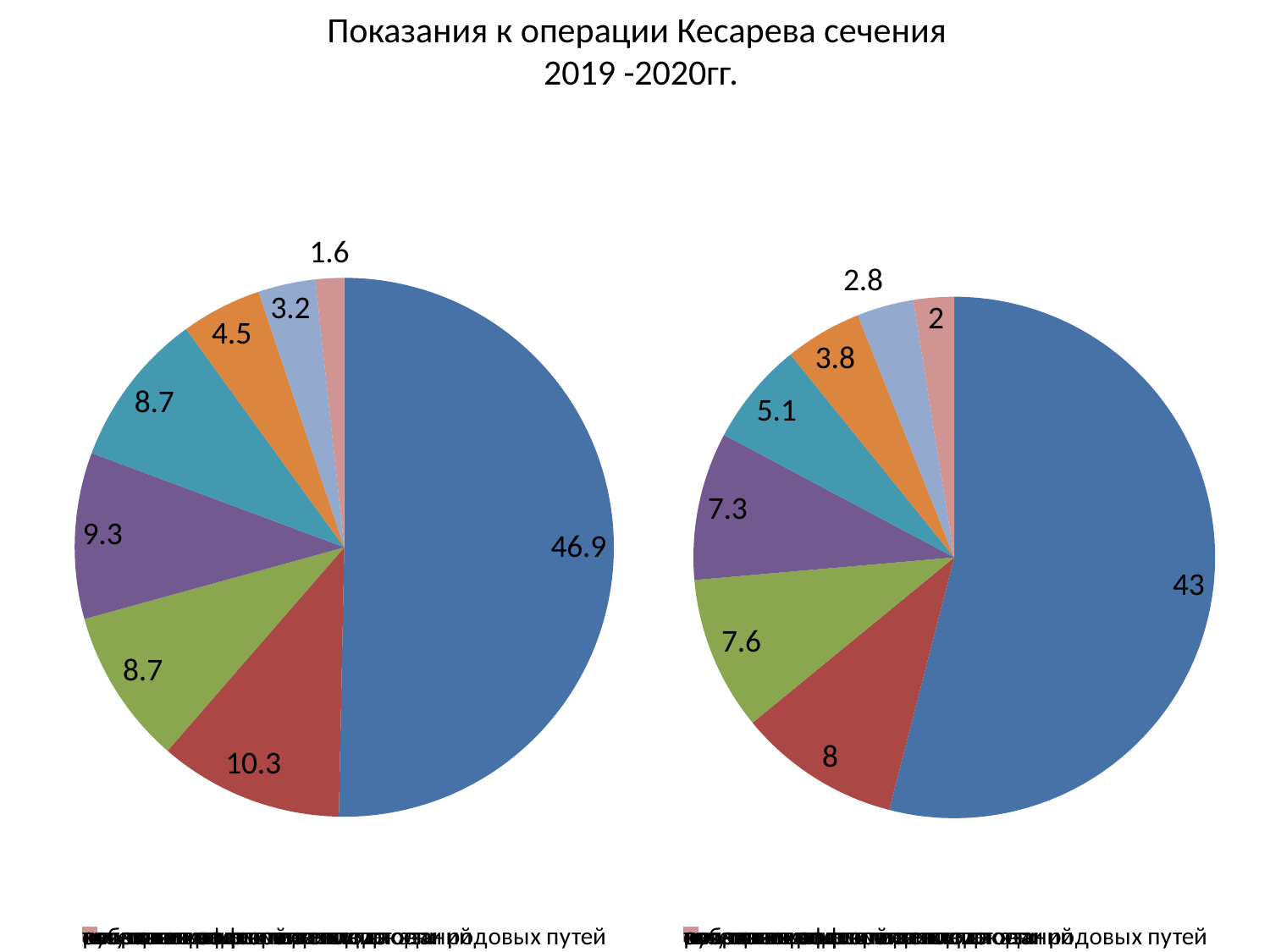
In the left pie chart, what value is labelled on the red slice? 10.3 In the right pie chart, what is the value of the smallest slice? 2 What type of chart is used on this slide? pie chart In the left pie chart, what is the value of the smallest slice? 1.6 How many slices does the left pie chart have? 8 How many slices does the right pie chart have? 8 What is the difference between the second-largest slice of the left pie chart (10.3) and the second-largest slice of the right pie chart (8)? 2.3 Which pie chart has the larger value for its largest slice, the left or the right? left What is the title of the slide? Показания к операции Кесарева сечения 2019 -2020гг. In the left pie chart, what is the value of the largest slice? 46.9 What is the difference between the largest slice of the left pie chart (46.9) and the largest slice of the right pie chart (43)? 3.9 In the right pie chart, what is the value of the largest slice? 43